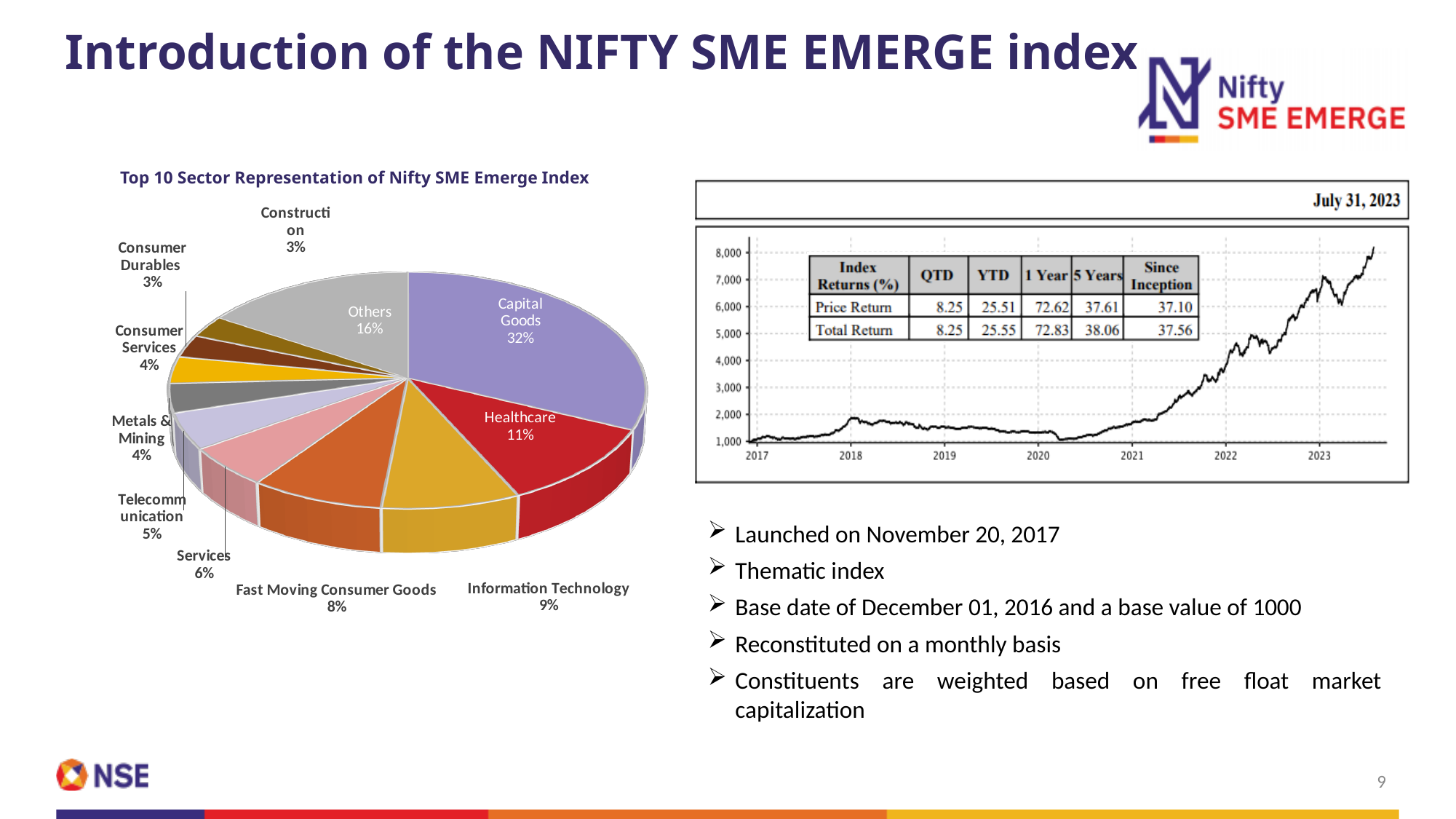
What kind of chart is 'Top 10 Sector Representation of Nifty SME Emerge Index'? Pie chart In the pie chart 'Top 10 Sector Representation of Nifty SME Emerge Index', how many slices are shown? 11 In the table inside the line chart on the right, what is the 1 Year Price Return (%)? 72.62 In the pie chart 'Top 10 Sector Representation of Nifty SME Emerge Index', what is the difference in percentage points between Capital Goods and Healthcare? 21 percentage points In the pie chart 'Top 10 Sector Representation of Nifty SME Emerge Index', what share does Capital Goods have? 32% In the pie chart 'Top 10 Sector Representation of Nifty SME Emerge Index', what share does Healthcare have? 11% What kind of chart is the chart on the right dated July 31, 2023? Line chart In the pie chart 'Top 10 Sector Representation of Nifty SME Emerge Index', which is larger, Information Technology or Services? Information Technology In the line chart on the right dated July 31, 2023, is the index value at the start of 2021 greater or less than 2,000? less In the line chart on the right dated July 31, 2023, does the index value generally rise or fall between 2021 and 2023? Rise In the pie chart 'Top 10 Sector Representation of Nifty SME Emerge Index', what share does Fast Moving Consumer Goods have? 8% In the pie chart 'Top 10 Sector Representation of Nifty SME Emerge Index', which named sector (excluding Others) has the largest share? Capital Goods